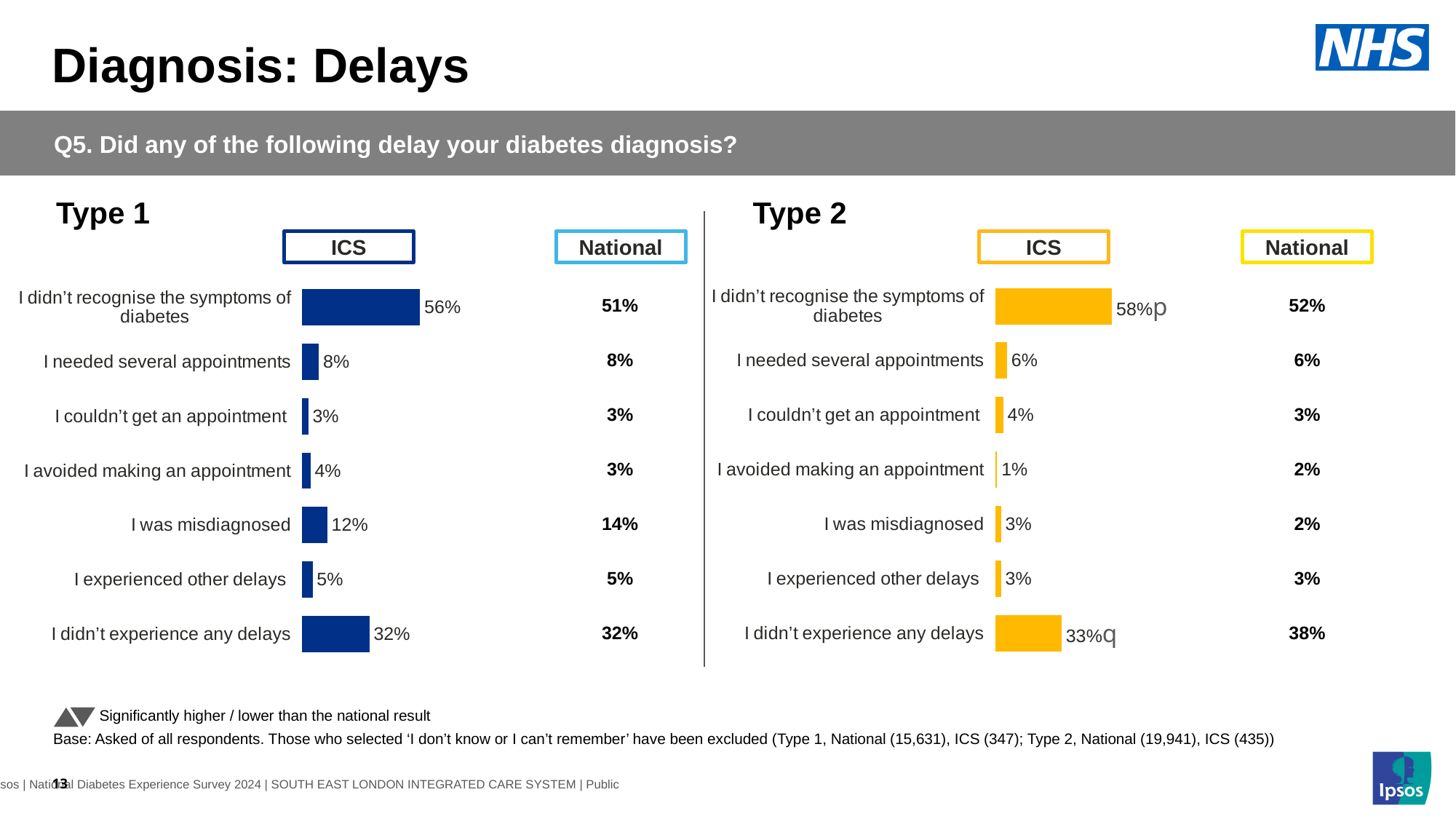
In the Type 2 chart, what is the difference between the National and ICS values for 'I didn't experience any delays'? 5% In the Type 1 chart, what is the ICS value for 'I didn't recognise the symptoms of diabetes'? 56% What colour are the ICS bars in the Type 2 chart? yellow/orange In the Type 2 chart, which category has the lowest ICS value? I avoided making an appointment In the Type 2 chart, what is the National value for 'I didn't experience any delays'? 38% In the Type 1 chart, is the ICS value for 'I was misdiagnosed' larger or smaller than the National value? smaller In the Type 1 chart, what is the difference between the ICS and National values for 'I didn't recognise the symptoms of diabetes'? 5% In the Type 2 chart, what is the ICS value for 'I didn't experience any delays'? 33% What type of chart is used for the ICS values in the Type 1 chart? bar chart In the Type 1 chart, what is the National value for 'I was misdiagnosed'? 14% In the Type 2 chart, which category has the highest ICS value? I didn't recognise the symptoms of diabetes How many categories are shown in the Type 1 chart? 7